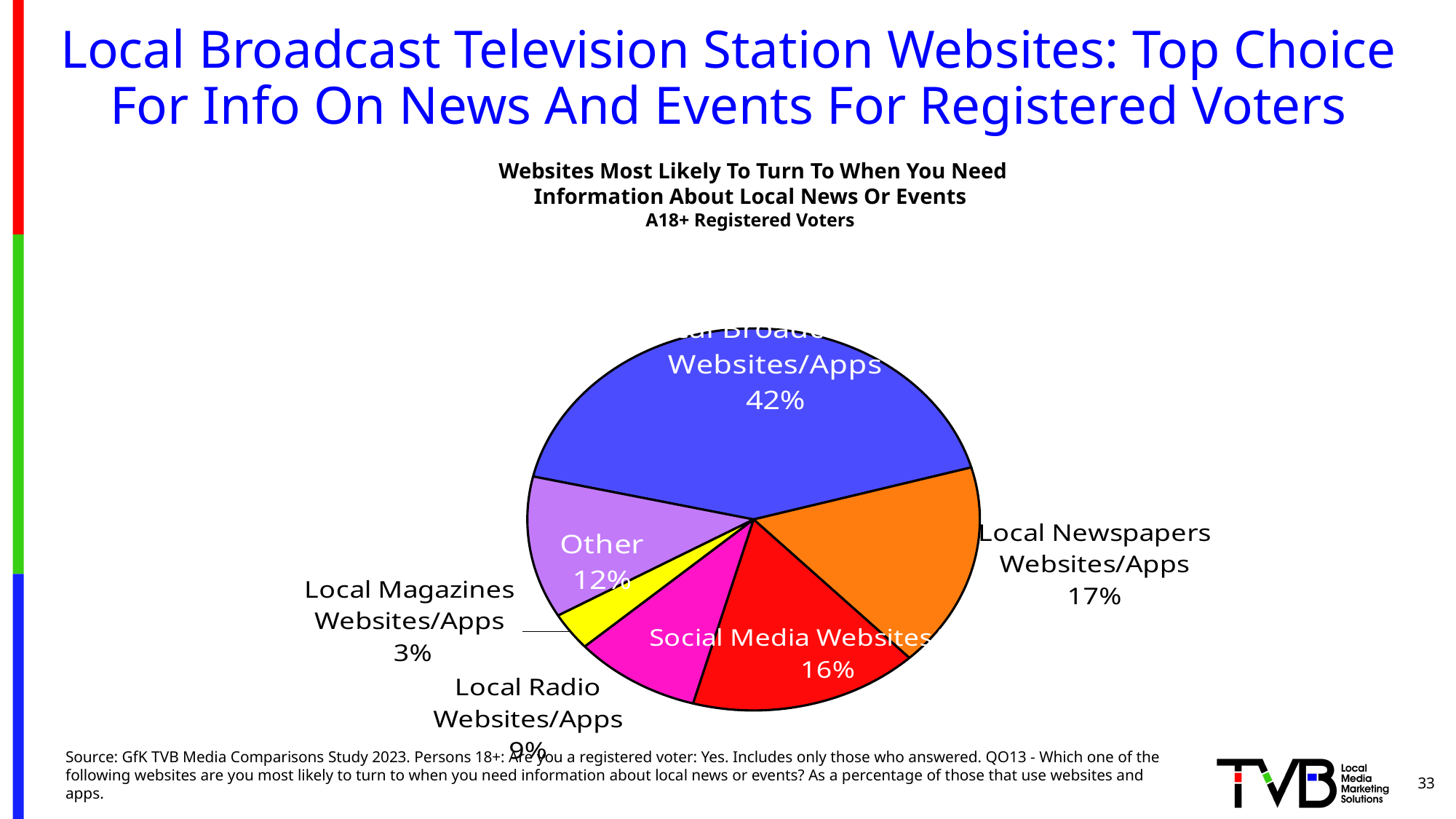
How many slices does the pie chart have? 6 Which category has the smallest slice of the pie? Local Magazines Websites/Apps What percentage is shown for Social Media Websites? 16% What kind of chart is shown on the slide? pie chart What share of registered voters chose Local Newspapers Websites/Apps? 17% Which is larger, the Other slice or the Local Radio Websites/Apps slice? Other What share of the pie is labelled Other? 12% What percentage is shown on the largest slice of the pie? 42% What share is shown for Local Radio Websites/Apps? 9% How many percentage points larger is the Other slice than the Local Radio Websites/Apps slice? 3% What percentage is shown for Local Magazines Websites/Apps? 3% Which audience group does the chart subtitle say the data covers? A18+ Registered Voters